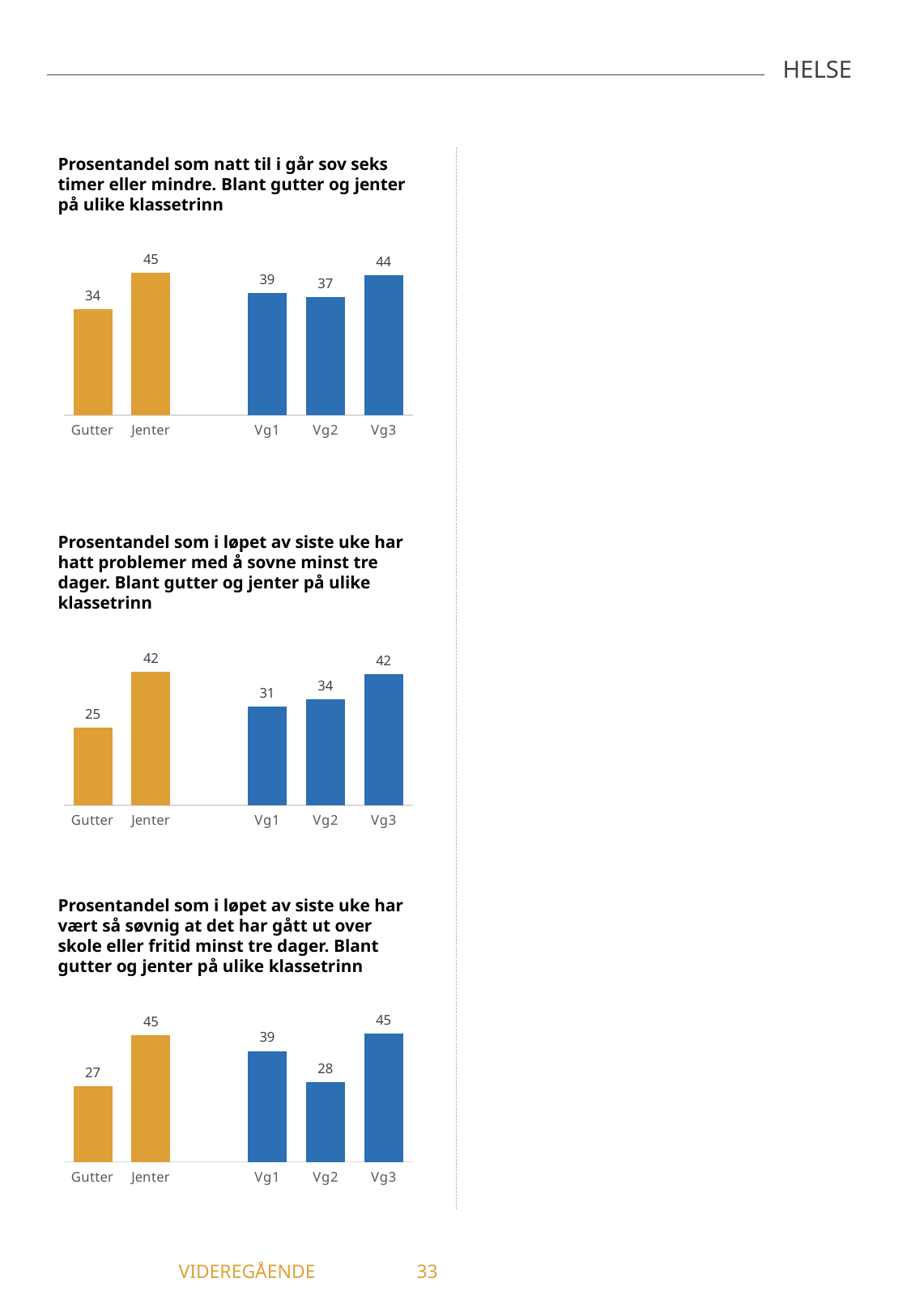
In the bottom chart (so sleepy it affected school or leisure), which category has the lowest value? Gutter How many bars does the top chart (sleeping six hours or less) have? 5 In the middle chart (problems falling asleep), do the values rise or fall from Vg1 to Vg3? rise In the bottom chart (so sleepy it affected school or leisure), what is the value for Vg2? 28 In the middle chart (problems falling asleep), which is larger, Vg1 or Vg2? Vg2 In the top chart (sleeping six hours or less), what is the value for Vg2? 37 In the top chart (sleeping six hours or less), which category has the lowest value? Gutter What type of chart is the middle chart (problems falling asleep)? bar chart In the top chart (sleeping six hours or less), what is the difference between Jenter and Gutter? 11 In the bottom chart (so sleepy it affected school or leisure), what is the difference between Vg3 and Vg2? 17 In the middle chart (problems falling asleep), what is the value for Gutter? 25 In the top chart (sleeping six hours or less), what is the value for Jenter? 45